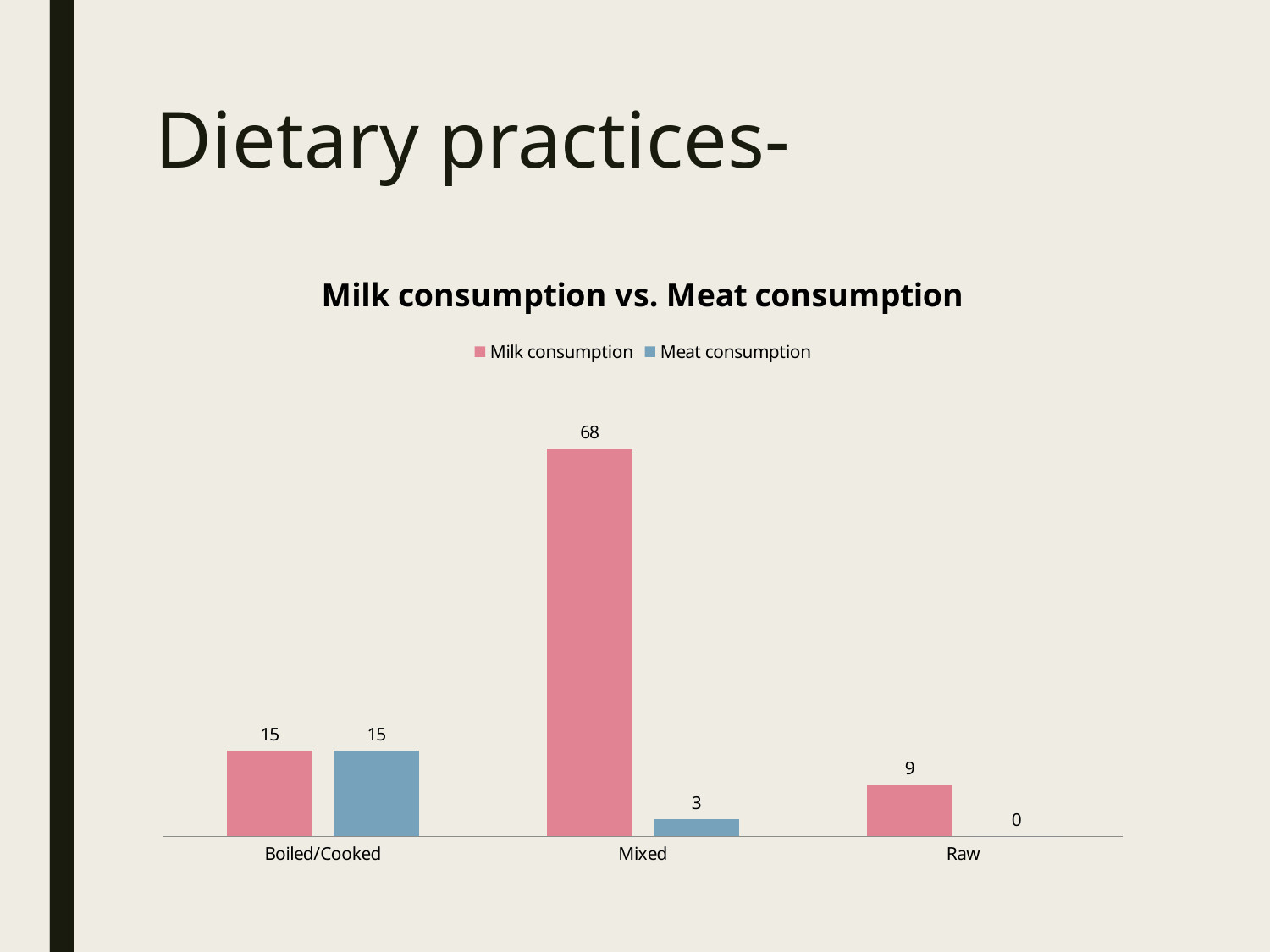
What is the Milk consumption value for Mixed? 68 What is the title of the chart? Milk consumption vs. Meat consumption How many categories are shown on the x axis? 3 Which category has the highest Milk consumption value? Mixed What kind of chart is shown on the slide? Bar chart Which is larger for Raw: Milk consumption or Meat consumption? Milk consumption How many series does the legend list? 2 What is the difference between Milk consumption and Meat consumption for Mixed? 65 What is the Meat consumption value for Mixed? 3 What is the Milk consumption value for Raw? 9 What is the Meat consumption value for Raw? 0 Which category has the lowest Meat consumption value? Raw